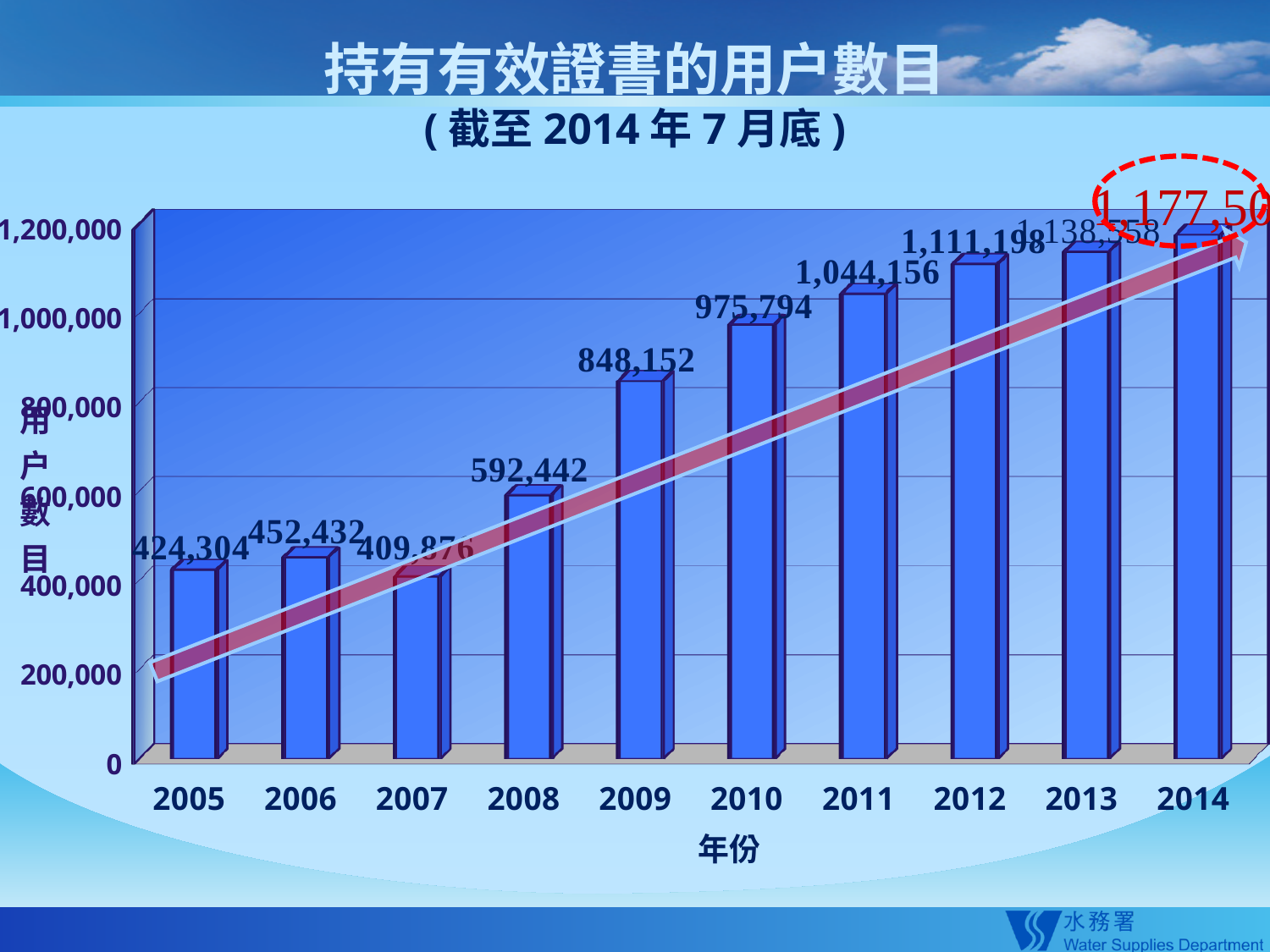
What is the value for 2008? 592,442 What is the difference between the values for 2006 and 2005? 28,128 Is the value for 2014 greater or less than 1,000,000? greater What kind of chart is shown on the slide? bar chart How many years are shown on the x axis? 10 What is the value for 2012? 1,111,198 Do the values generally rise or fall from 2005 to 2014? rise What is the value for 2005? 424,304 Which is larger, the value for 2010 or the value for 2008? 2010 What is the difference between the values for 2009 and 2008? 255,710 Which year has the highest value? 2014 What is the value for 2011? 1,044,156